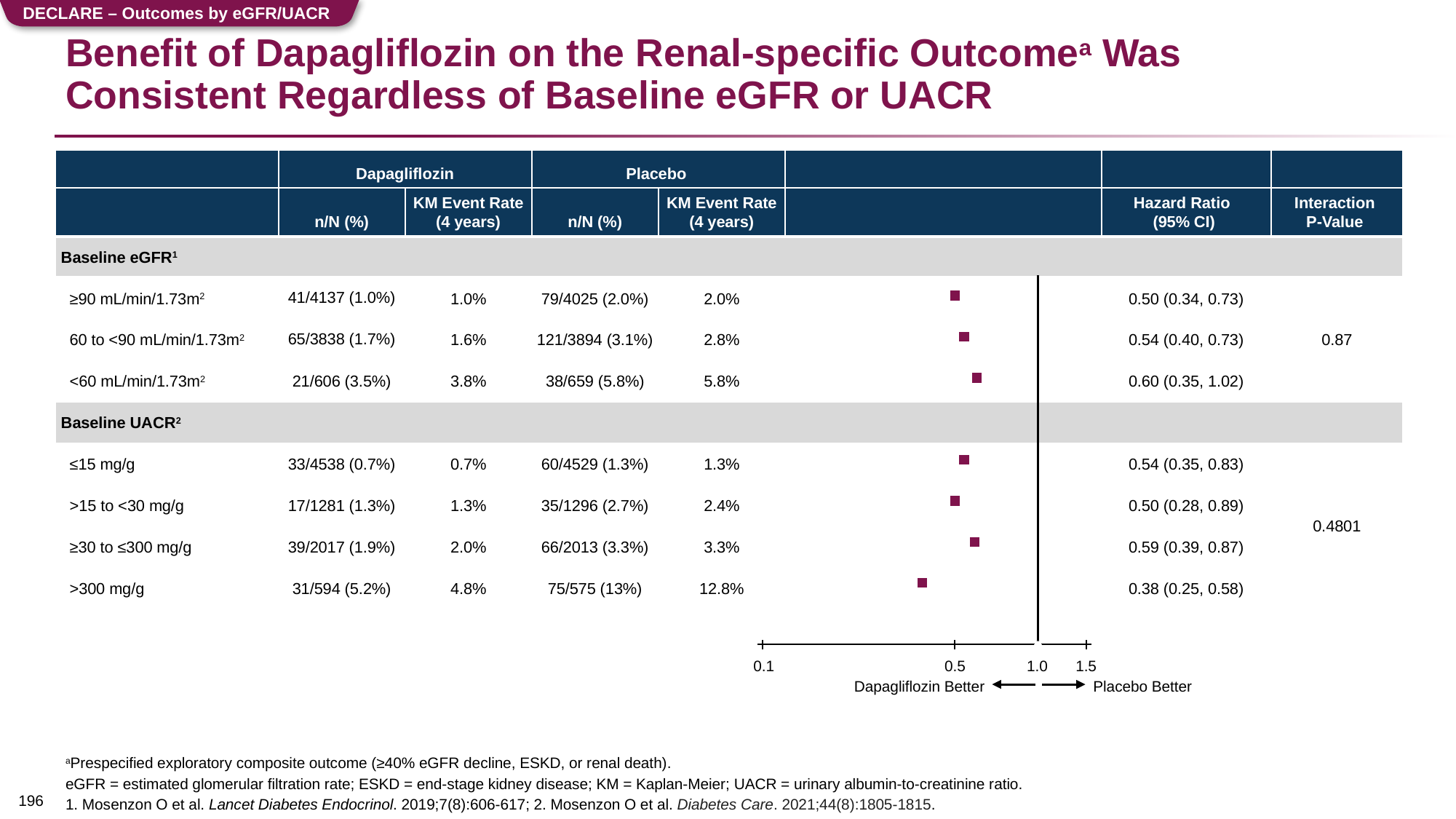
Which subgroup has the highest hazard ratio in the forest plot? <60 mL/min/1.73m² What is the interaction P-value shown for the baseline UACR subgroups? 0.4801 Is the plotted hazard ratio for the ≥30 to ≤300 mg/g subgroup greater or less than 1.0? less Which subgroup has the lowest hazard ratio in the forest plot? >300 mg/g What is the hazard ratio (95% CI) plotted for the baseline UACR >300 mg/g subgroup? 0.38 (0.25, 0.58) What is the hazard ratio (95% CI) plotted for the baseline eGFR ≥90 mL/min/1.73m² subgroup? 0.50 (0.34, 0.73) How many hazard ratio points are plotted in the forest plot? 7 Which has the larger hazard ratio: the ≥90 mL/min/1.73m² subgroup or the <60 mL/min/1.73m² subgroup? <60 mL/min/1.73m² What is the difference between the hazard ratio for the <60 mL/min/1.73m² subgroup and the >300 mg/g subgroup? 0.22 What kind of chart is shown in the middle of the table on this slide? Forest plot What is the hazard ratio (95% CI) for the <60 mL/min/1.73m² eGFR subgroup? 0.60 (0.35, 1.02) What label appears to the left of the arrow below the forest plot's x axis? Dapagliflozin Better